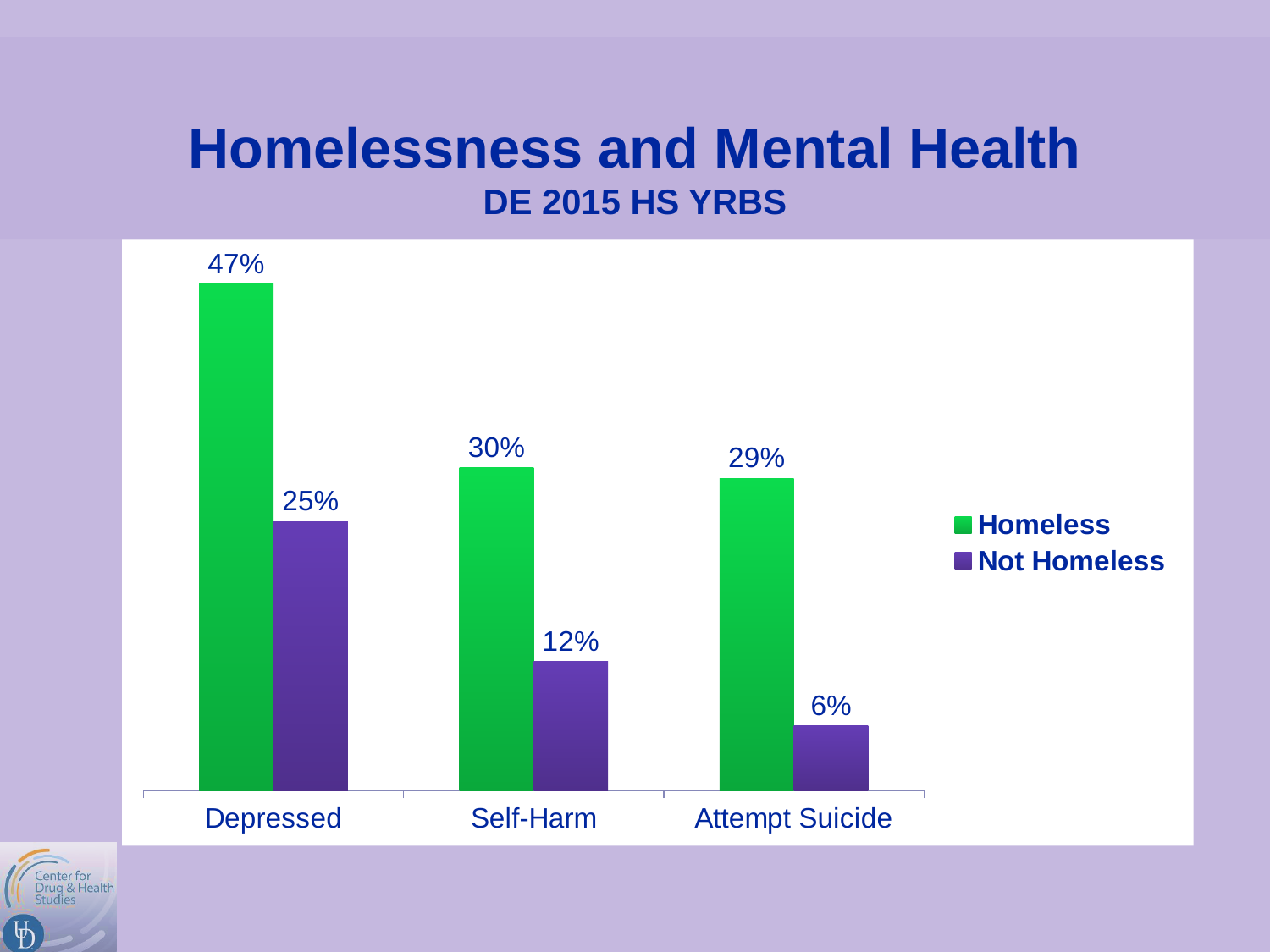
How many series does the legend list? 2 What is the difference between the Homeless and Not Homeless values for Self-Harm? 18% Which category has the lowest Not Homeless value? Attempt Suicide What is the difference between the Homeless and Not Homeless values for Depressed? 22% What is the Homeless value for Attempt Suicide? 29% Which is larger: the Homeless value for Self-Harm or the Not Homeless value for Depressed? Homeless value for Self-Harm What is the Not Homeless value for Attempt Suicide? 6% What is the Not Homeless value for Self-Harm? 12% How many categories are shown on the x axis? 3 Which category has the highest Homeless value? Depressed What kind of chart is shown on the slide? Bar chart What percentage of Homeless students reported being Depressed? 47%